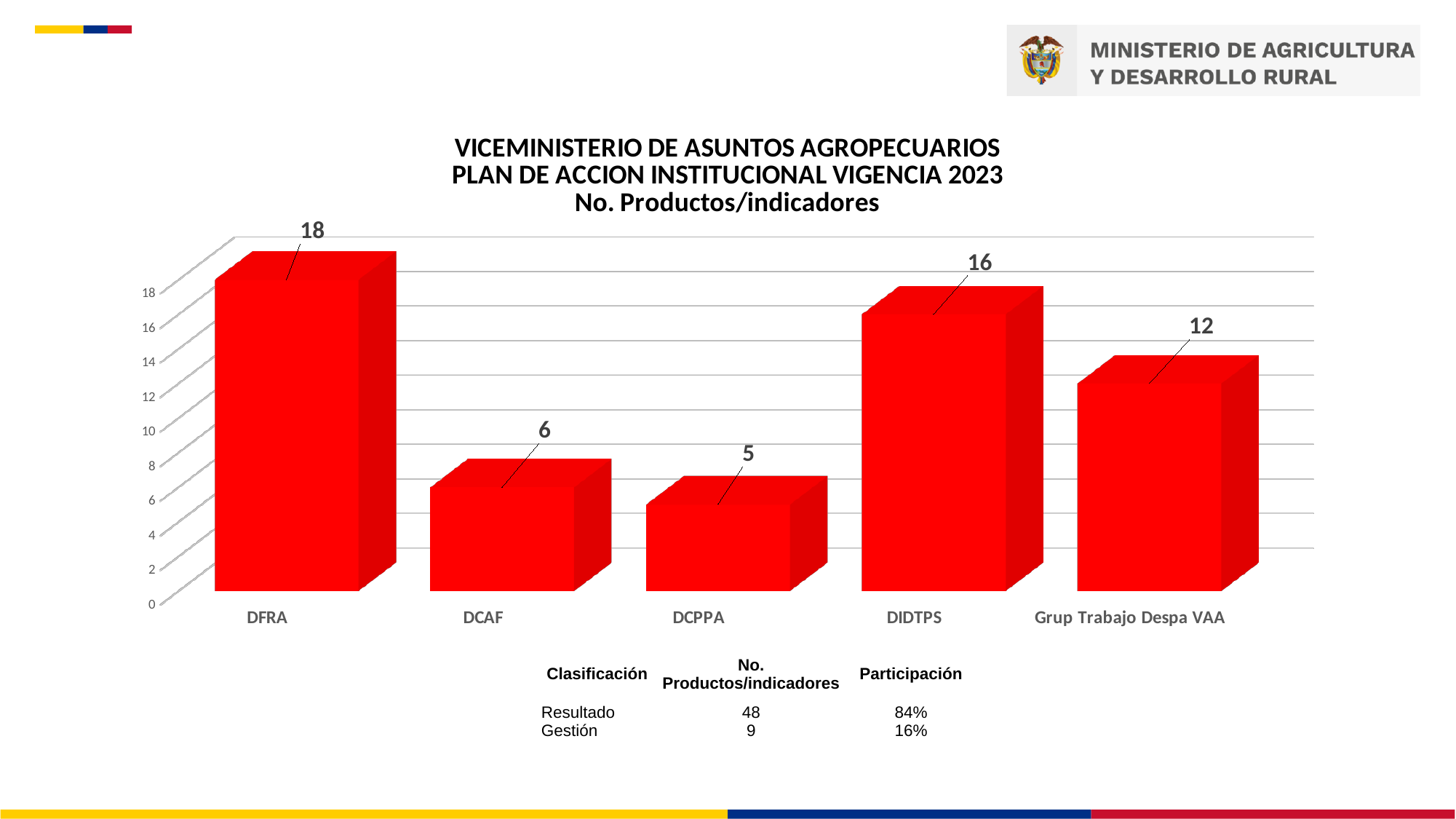
Which is larger, the value for DCAF or the value for Grup Trabajo Despa VAA? Grup Trabajo Despa VAA What is the value for DCPPA? 5 What is the value for DCAF? 6 What is the value for Grup Trabajo Despa VAA? 12 What is the difference between the values for DFRA and DIDTPS? 2 What is the value for DIDTPS? 16 Which category has the highest value? DFRA How many categories are shown on the x axis? 5 What colour are the bars in the chart? red What is the value for DFRA? 18 What kind of chart is shown on the slide? bar chart Which category has the lowest value? DCPPA